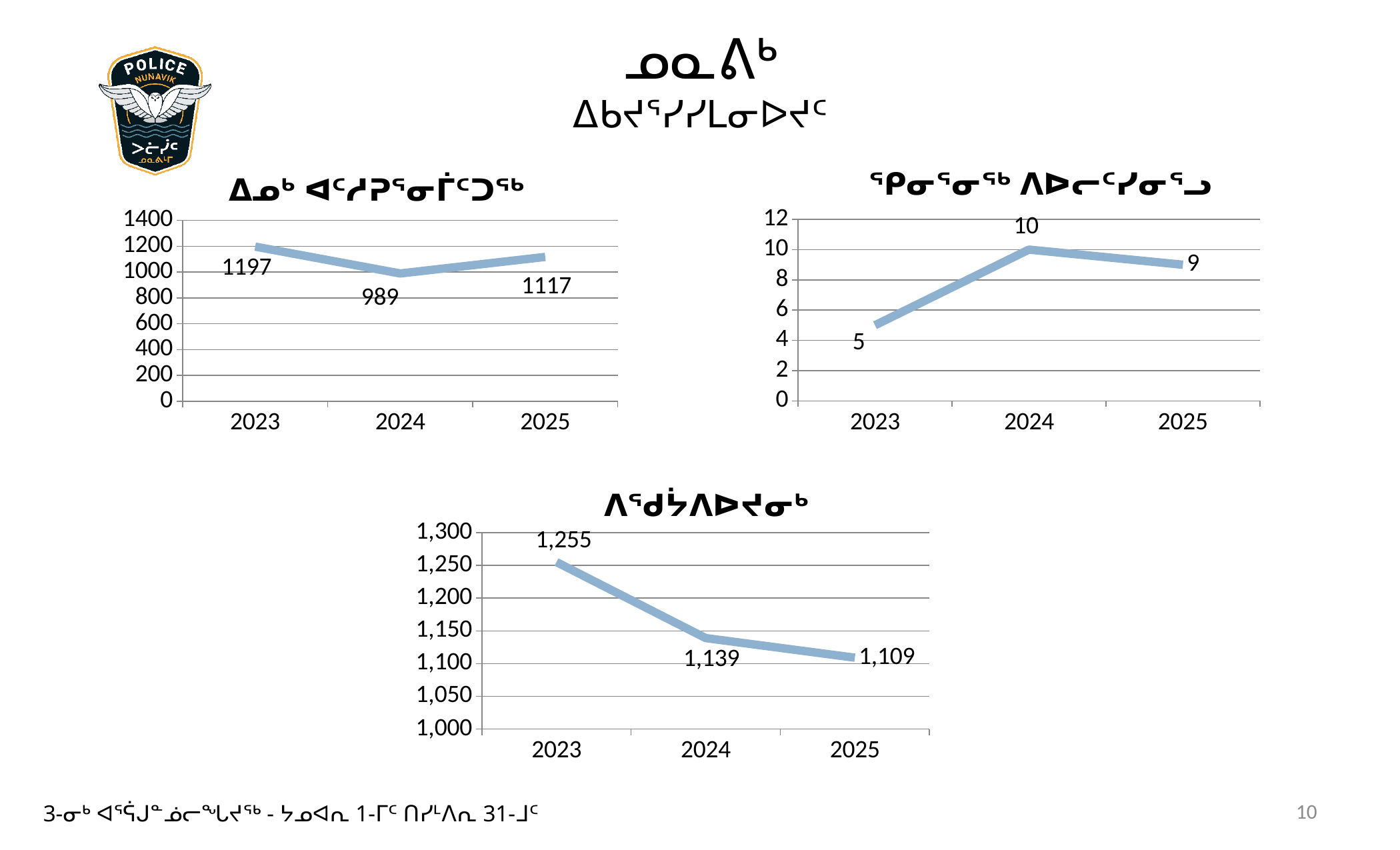
What type of chart is the bottom chart? line chart In the top-right chart, what is the value for 2024? 10 In the top-left chart, which year has the lowest value? 2024 In the top-right chart, which year has the highest value? 2024 In the bottom chart, do the values rise or fall from 2023 to 2025? fall In the bottom chart, what is the value for 2025? 1,109 In the top-right chart, what is the difference between the 2024 and 2023 values? 5 In the top-right chart, is the value for 2025 greater or less than 8? greater In the top-left chart, what is the value for 2024? 989 In the top-left chart, what is the value for 2023? 1197 In the top-left chart, what is the difference between the 2023 and 2025 values? 80 In the bottom chart, what is the difference between the 2023 and 2024 values? 116